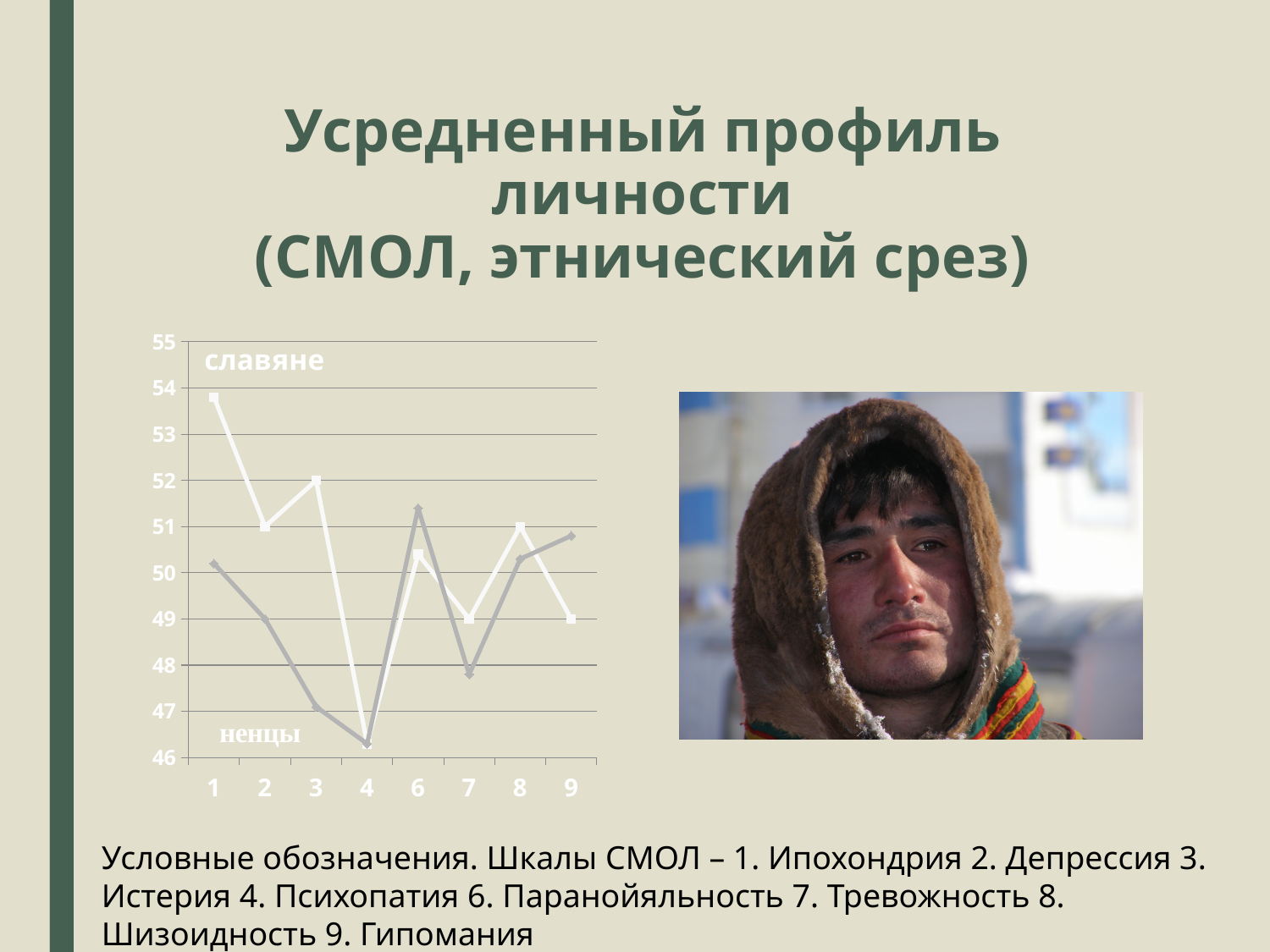
What is the value for славяне at scale 3? 52 What kind of chart is shown on the slide? line chart Is the value for славяне at scale 1 greater or less than 53? greater Is the value for ненцы at scale 9 greater or less than 50? greater How many series (lines) are plotted on the chart? 2 At scale 6, which series has the higher value, славяне or ненцы? ненцы At which scale does the ненцы series reach its lowest value? 4 How many scale categories are shown along the x axis of the chart? 8 Is the value for ненцы at scale 4 greater or less than 47? less What are the names of the two series plotted on the chart? славяне and ненцы At which scale does the славяне series reach its highest value? 1 At scale 1, which series has the higher value, славяне or ненцы? славяне